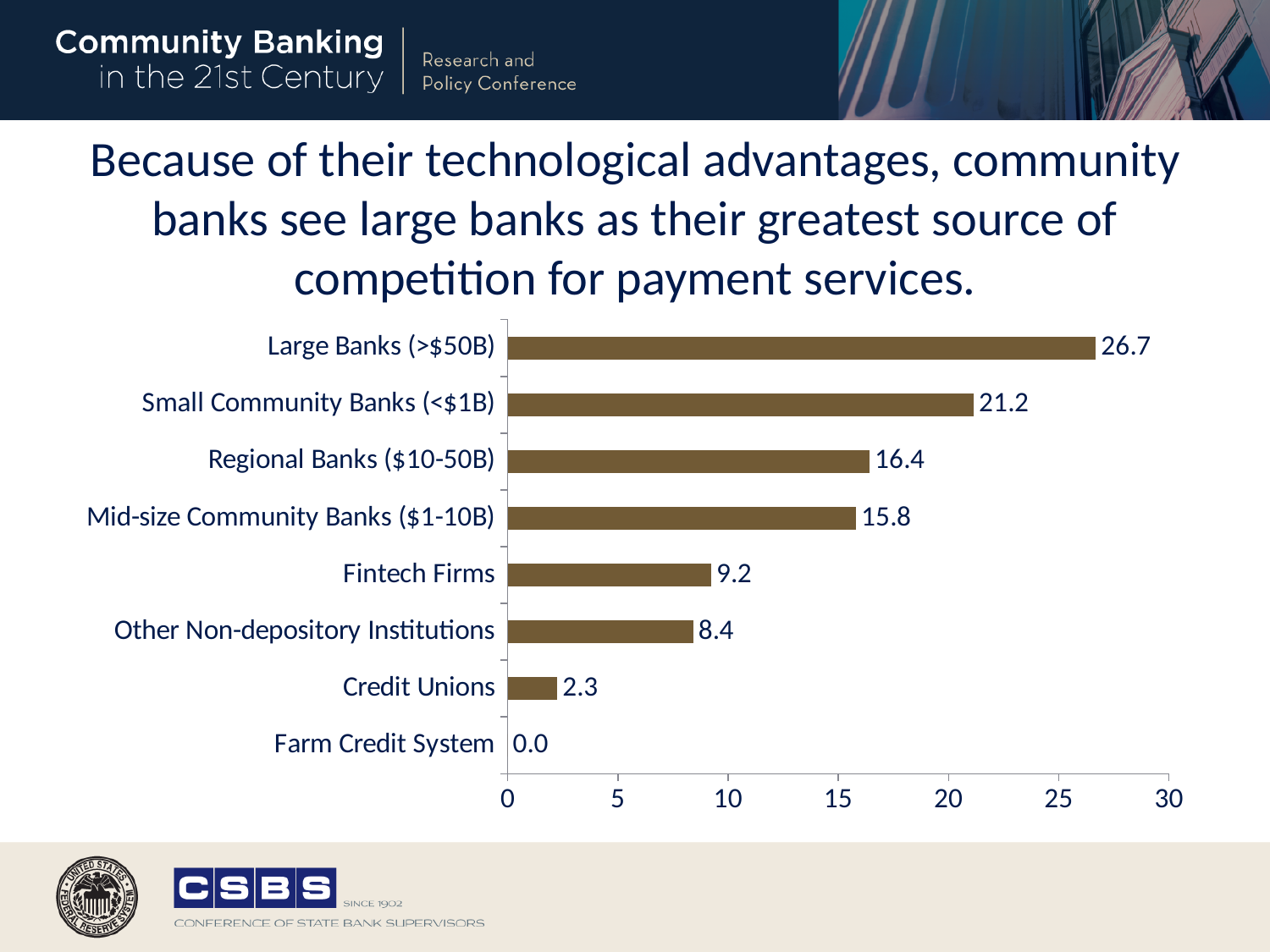
Which is larger, the value for Regional Banks ($10-50B) or Mid-size Community Banks ($1-10B)? Regional Banks ($10-50B) What is the value for Fintech Firms? 9.2 Which category has the lowest value? Farm Credit System What is the difference between the values for Fintech Firms and Other Non-depository Institutions? 0.8 What kind of chart is shown on the slide? Bar chart What is the difference between the values for Large Banks (>$50B) and Small Community Banks (<$1B)? 5.5 What is the value for Large Banks (>$50B)? 26.7 What is the maximum value shown on the horizontal axis? 30 How many categories are shown in the chart? 8 What is the value for Credit Unions? 2.3 Is the value for Small Community Banks (<$1B) greater or less than 20? greater Which category has the highest value? Large Banks (>$50B)